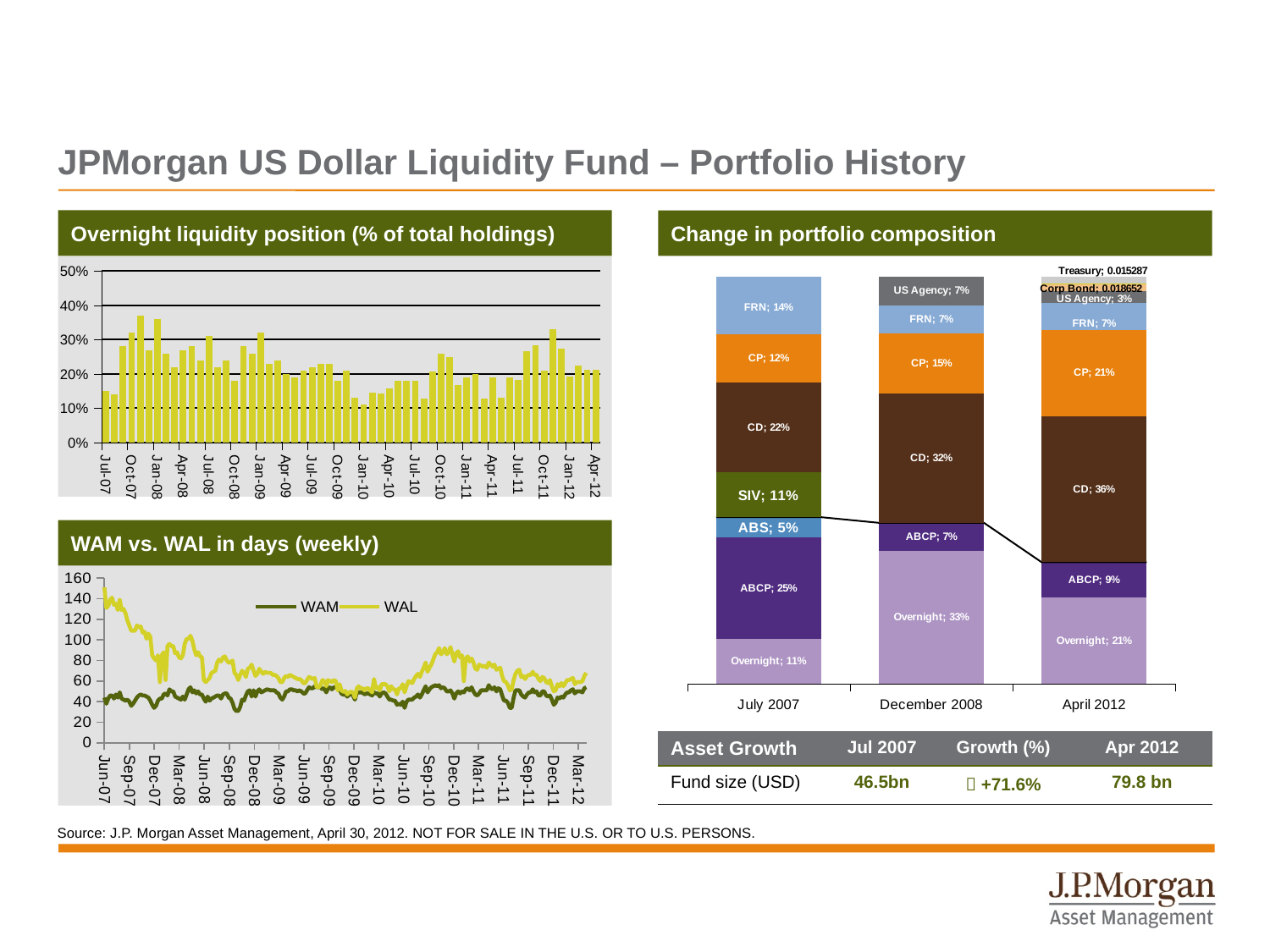
In the 'Change in portfolio composition' chart, by how many percentage points did the CP share increase from July 2007 to April 2012? 9 percentage points In the 'Change in portfolio composition' chart, which period has the larger ABCP share, July 2007 or December 2008? July 2007 In the 'WAM vs. WAL in days (weekly)' chart, is the WAL value at Jun-07 greater or less than 120? greater In the 'Change in portfolio composition' chart, what is the Overnight share in December 2008? 33% In the 'WAM vs. WAL in days (weekly)' chart, does the WAL line rise or fall between Jun-07 and Dec-07? Fall How many series does the legend of the 'WAM vs. WAL in days (weekly)' chart list? 2 In the 'Change in portfolio composition' chart, which labelled category has the smallest share in July 2007? ABS What kind of chart is 'Overnight liquidity position (% of total holdings)'? Bar chart In the 'Change in portfolio composition' chart, which category has the largest share in April 2012? CD In the 'Change in portfolio composition' chart, what is the FRN share in July 2007? 14% In the 'Change in portfolio composition' chart, what is the CD share in April 2012? 36% How many stacked bars (time periods) are shown in the 'Change in portfolio composition' chart? 3